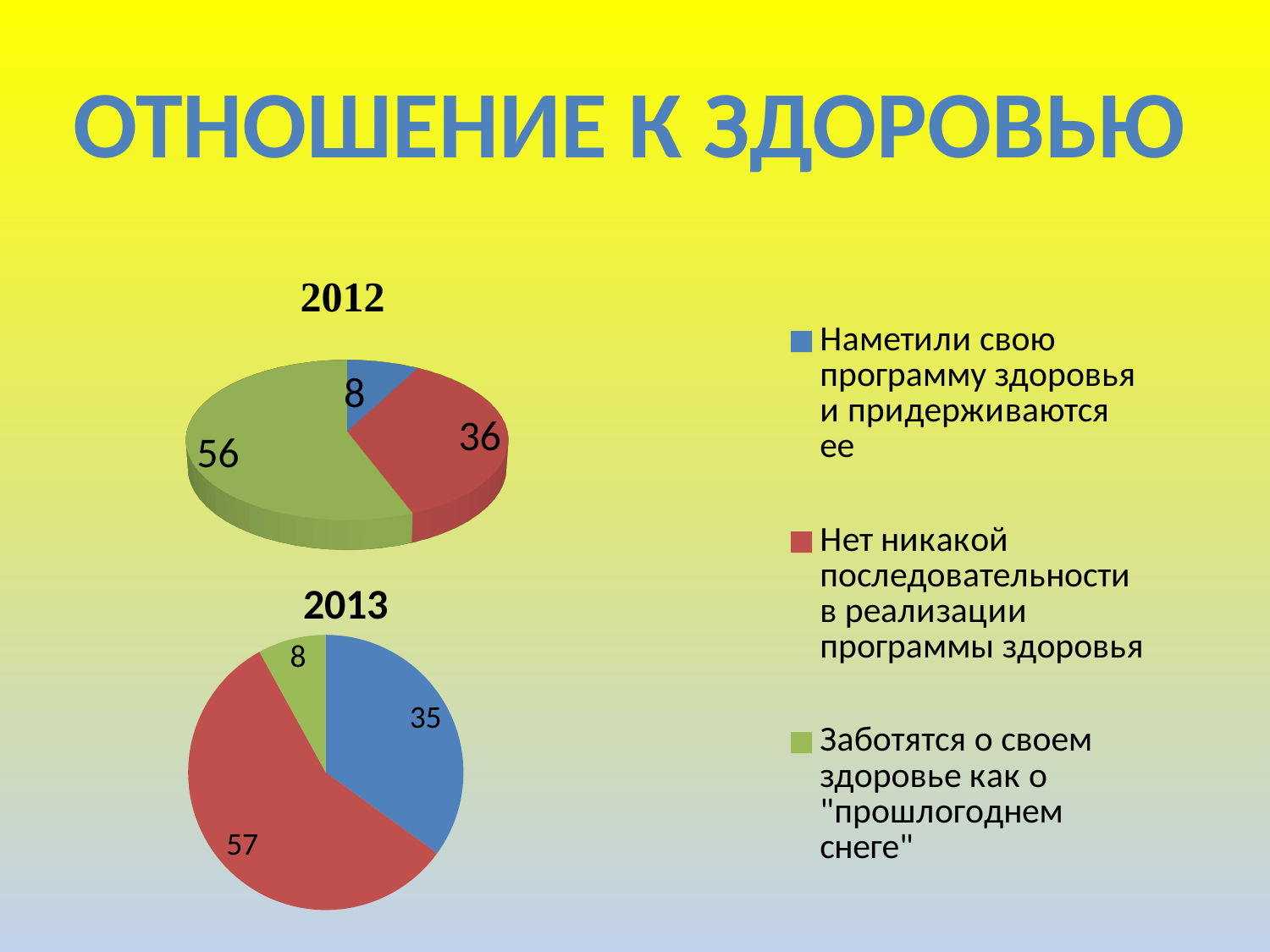
How many entries does the legend list? 3 What is the title of the slide? ОТНОШЕНИЕ К ЗДОРОВЬЮ In the "2012" chart, what is the difference between the green slice (56) and the red slice (36)? 20 In the "2012" chart, which slice is the largest? Заботятся о своем здоровье как о "прошлогоднем снеге" What type of chart is the "2012" chart? pie chart In the "2013" chart, what is the value of the red slice? 57 In the "2012" chart, what is the value of the red slice ("Нет никакой последовательности в реализации программы здоровья")? 36 How many slices does the "2013" chart have? 3 In the "2013" chart, what is the value of the blue slice ("Наметили свою программу здоровья и придерживаются ее")? 35 In the "2013" chart, which slice is the smallest? Заботятся о своем здоровье как о "прошлогоднем снеге" In the "2012" chart, what is the value of the green slice ("Заботятся о своем здоровье как о "прошлогоднем снеге"")? 56 In the "2013" chart, which is larger: the red slice or the blue slice? the red slice